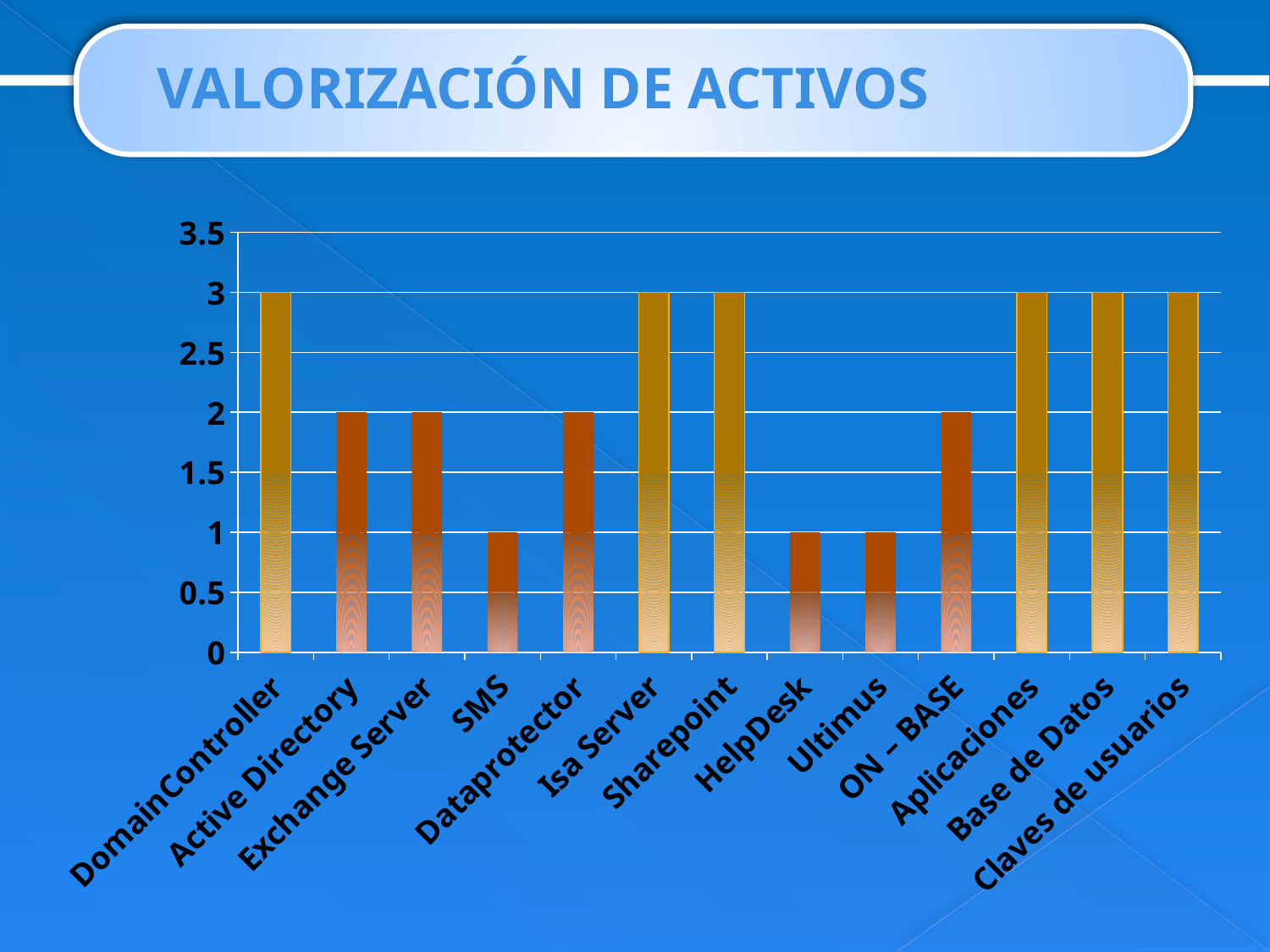
Is the value for Ultimus greater or less than 1.5? less What is the value for DomainController? 3 What is the value for ON – BASE? 2 How many categories are shown on the x axis? 13 Which is larger, the value for Ultimus or the value for Dataprotector? Dataprotector What is the value for Claves de usuarios? 3 What is the difference between the value for Exchange Server and the value for HelpDesk? 1 What is the value for Active Directory? 2 What is the difference between the value for Sharepoint and the value for SMS? 2 What kind of chart is shown on the slide? bar chart Which is larger, the value for Isa Server or the value for HelpDesk? Isa Server What is the value for SMS? 1